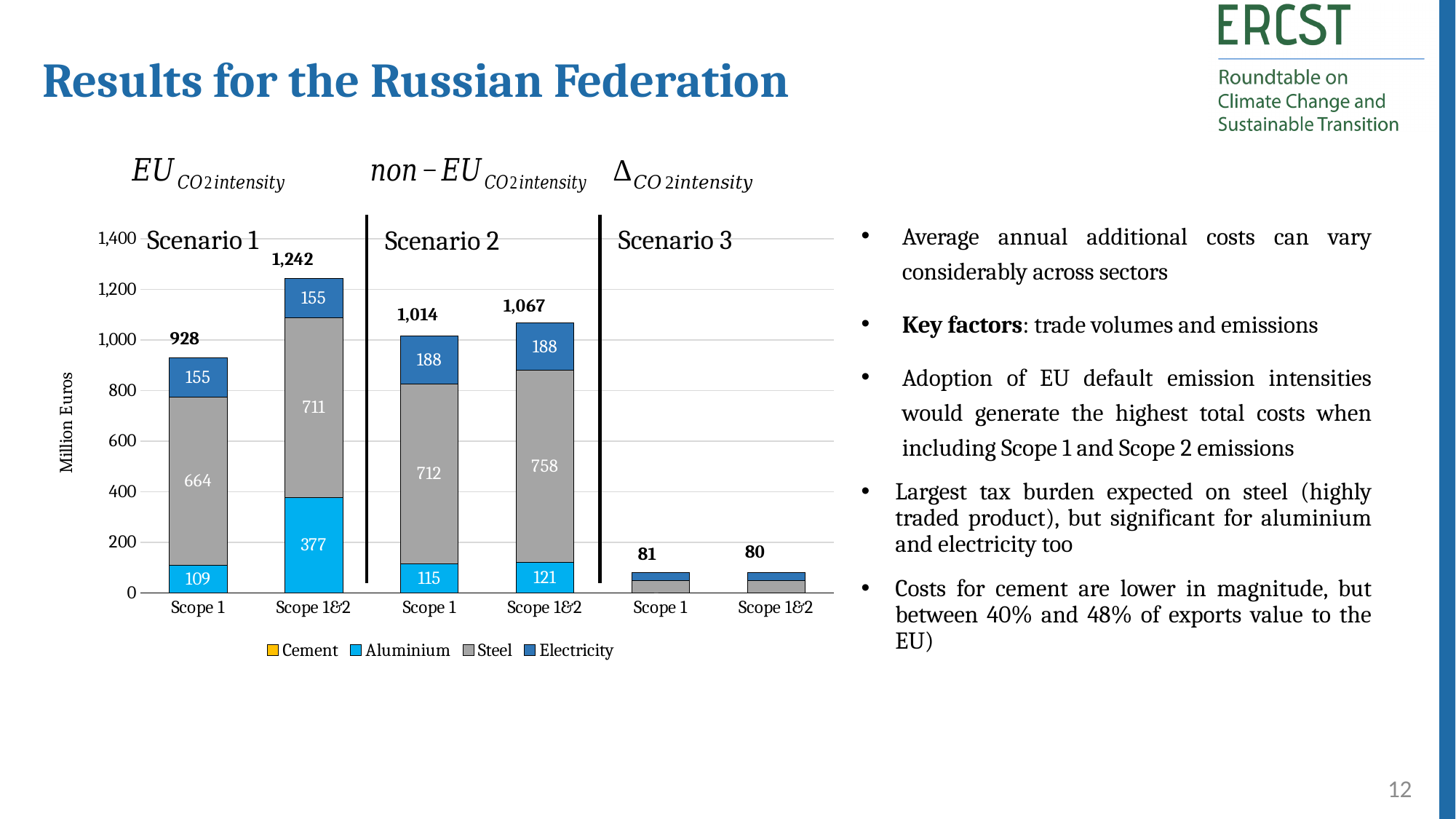
What kind of chart is shown on the slide? Stacked bar chart Which bar has the lowest total value? Scenario 3 Scope 1&2 What is the total value shown above the Scope 1&2 bar in Scenario 1? 1,242 What is the Electricity value in the Scope 1&2 bar of Scenario 2? 188 What is the Steel value in the Scope 1 bar of Scenario 2? 712 Which bar has the highest total value? Scenario 1 Scope 1&2 How many bars are plotted in the chart? 6 What is the difference between the total for Scenario 2 Scope 1&2 and the total for Scenario 2 Scope 1? 53 Which is larger: the Steel value in Scenario 1 Scope 1&2 or the Steel value in Scenario 2 Scope 1&2? Scenario 2 Scope 1&2 How many series does the legend list? 4 What is the Aluminium value in the Scope 1&2 bar of Scenario 1? 377 Is the total for Scenario 1 Scope 1 greater or less than 1,000? less